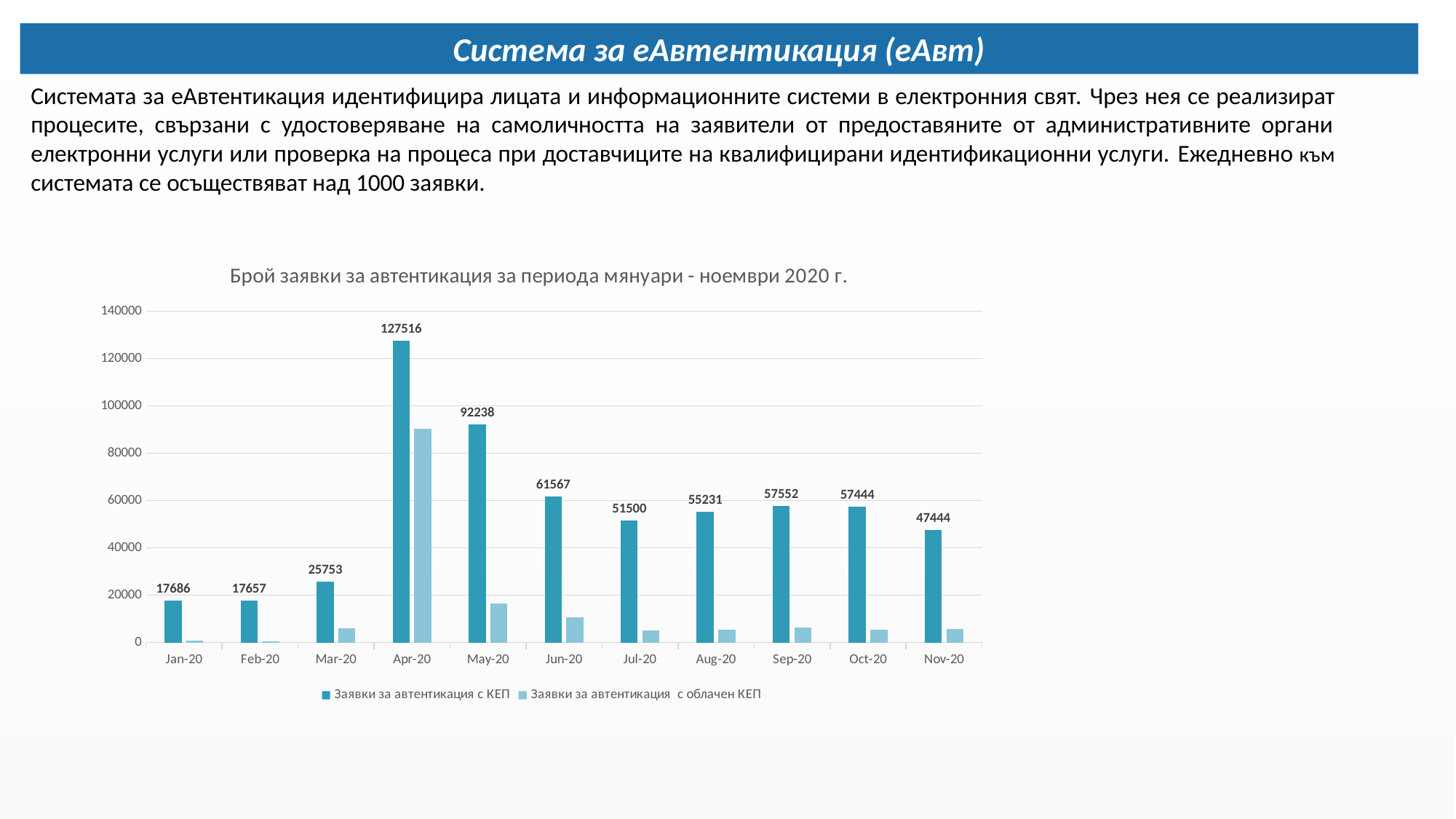
What kind of chart is shown on the slide? bar chart Is the value for Заявки за автентикация с облачен КЕП in Jun-20 greater or less than 20000? less How many months are shown on the x axis? 11 Is the value for Заявки за автентикация с облачен КЕП in Apr-20 greater or less than 80000? greater Which month has the lowest value for Заявки за автентикация с КЕП? Feb-20 What is the value for Заявки за автентикация с КЕП in Mar-20? 25753 What is the value for Заявки за автентикация с КЕП in Nov-20? 47444 How many series does the legend list? 2 What is the difference between the Apr-20 and May-20 values for Заявки за автентикация с КЕП? 35278 Which month has the highest value for Заявки за автентикация с КЕП? Apr-20 What is the value for Заявки за автентикация с КЕП in Apr-20? 127516 Which is larger for Заявки за автентикация с КЕП: Jun-20 or Jul-20? Jun-20